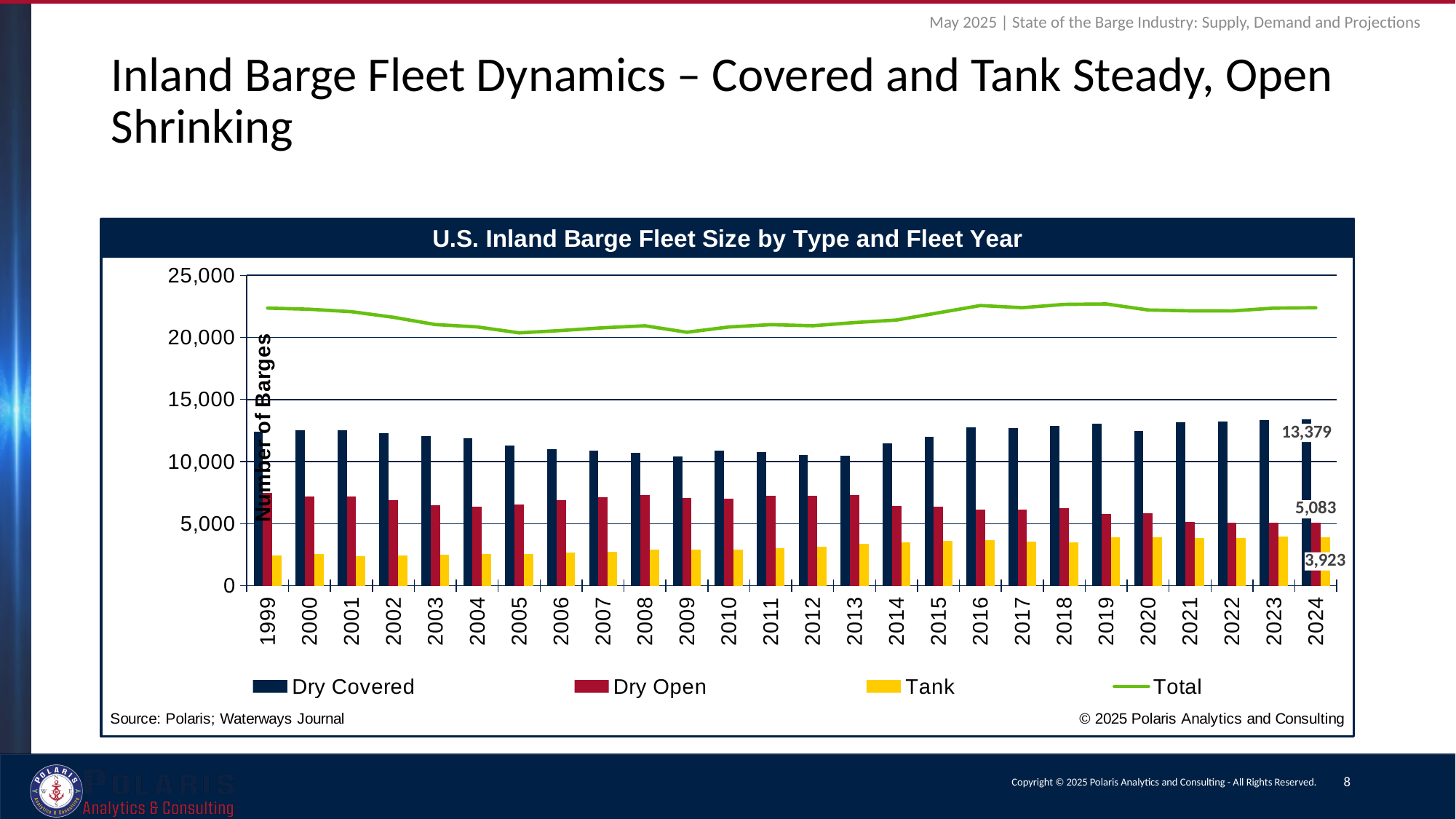
What is the value for Dry Open barges in 2024? 5,083 What kind of chart is this? Bar chart with a line Do the Dry Open values rise or fall from 1999 to 2024? fall Is the Total value in 2016 greater or less than 20,000? greater In 2024, how many more Dry Covered barges are there than Dry Open barges? 8,296 Is the Dry Covered value in 2009 greater or less than 15,000? less What is the y-axis title of the chart? Number of Barges How many series does the legend list? 4 What is the value for Tank barges in 2024? 3,923 How many years are shown on the x axis? 26 What is the value for Dry Covered barges in 2024? 13,379 In 2024, what is the difference between the Dry Open and Tank barge counts? 1,160